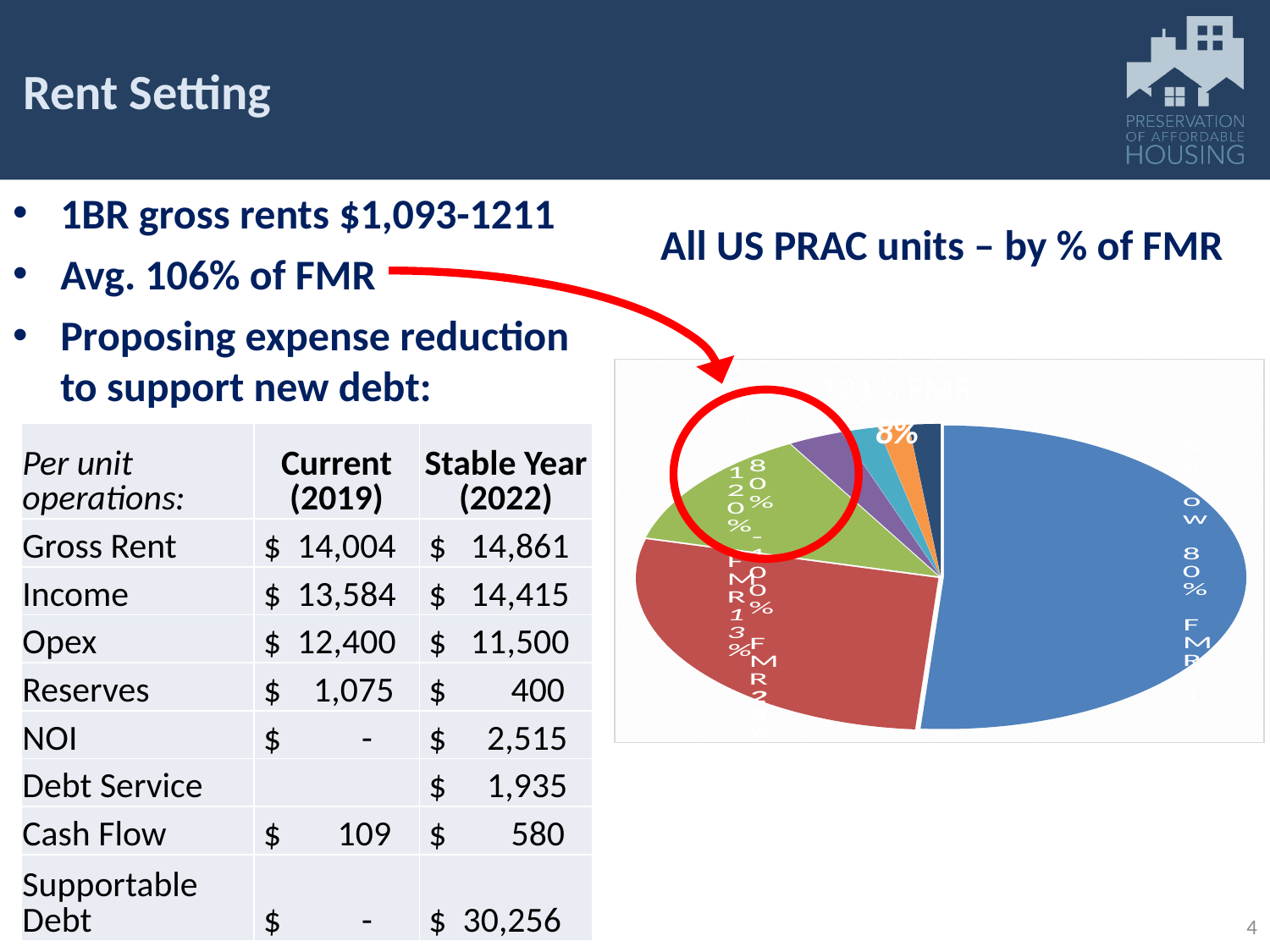
Which slice of the pie chart is larger, the red one or the green one? red Which slice of the pie chart is larger, the green one or the purple one? green How many slices does the pie chart have? 7 What is the title of the pie chart? All US PRAC units – by % of FMR Which slice of the pie chart is larger, the blue one or the red one? blue Which colour slice is the largest in the pie chart? blue What kind of chart is shown on the slide? pie chart